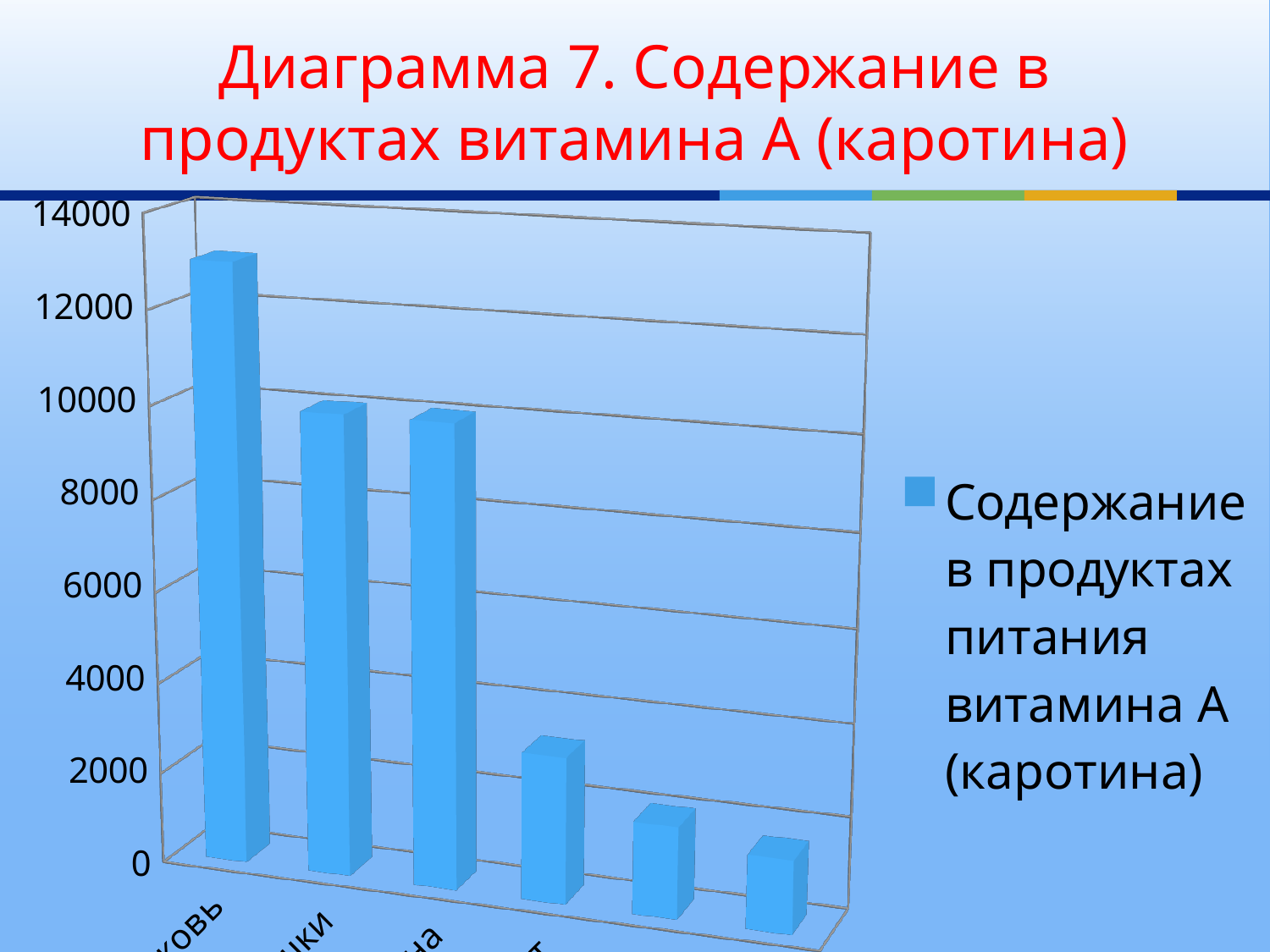
Which is larger, the first bar from the left or the fourth bar from the left? the first bar Is the value of the fourth bar from the left greater or less than 4000? less Is the value of the second bar from the left greater or less than 8000? greater Which bar has the lowest value? the last (rightmost) bar Is the value of the first (leftmost) bar greater or less than 12000? greater What is the legend entry for the series in the chart? Содержание в продуктах питания витамина А (каротина) What kind of chart is shown on the slide? bar chart How many series does the legend list? 1 Which bar has the highest value? the first (leftmost) bar How many bars are plotted in the chart? 6 Do the bar values generally rise or fall from left to right? fall